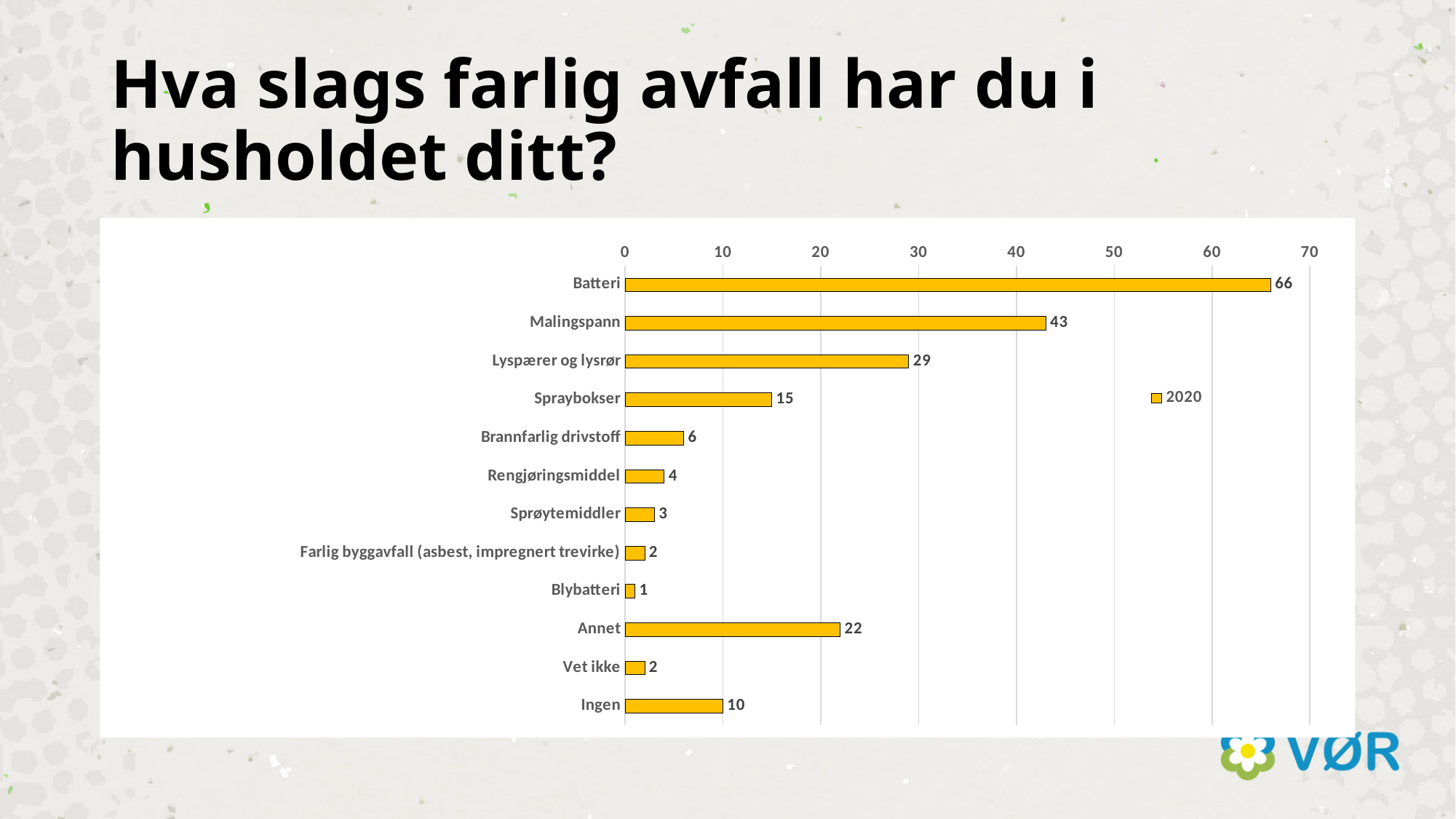
What is the difference between the values for Batteri and Malingspann? 23 Which category has the highest value? Batteri How many series does the legend list? 1 What is the value for Malingspann? 43 What is the legend entry for the series shown? 2020 Is the value for Lyspærer og lysrør greater or less than 20? greater Which category has the lowest value? Blybatteri What kind of chart is shown on the slide? bar chart What is the value for Annet? 22 How many categories are shown in the chart? 12 What is the value for Batteri? 66 Which is larger, the value for Spraybokser or the value for Annet? Annet